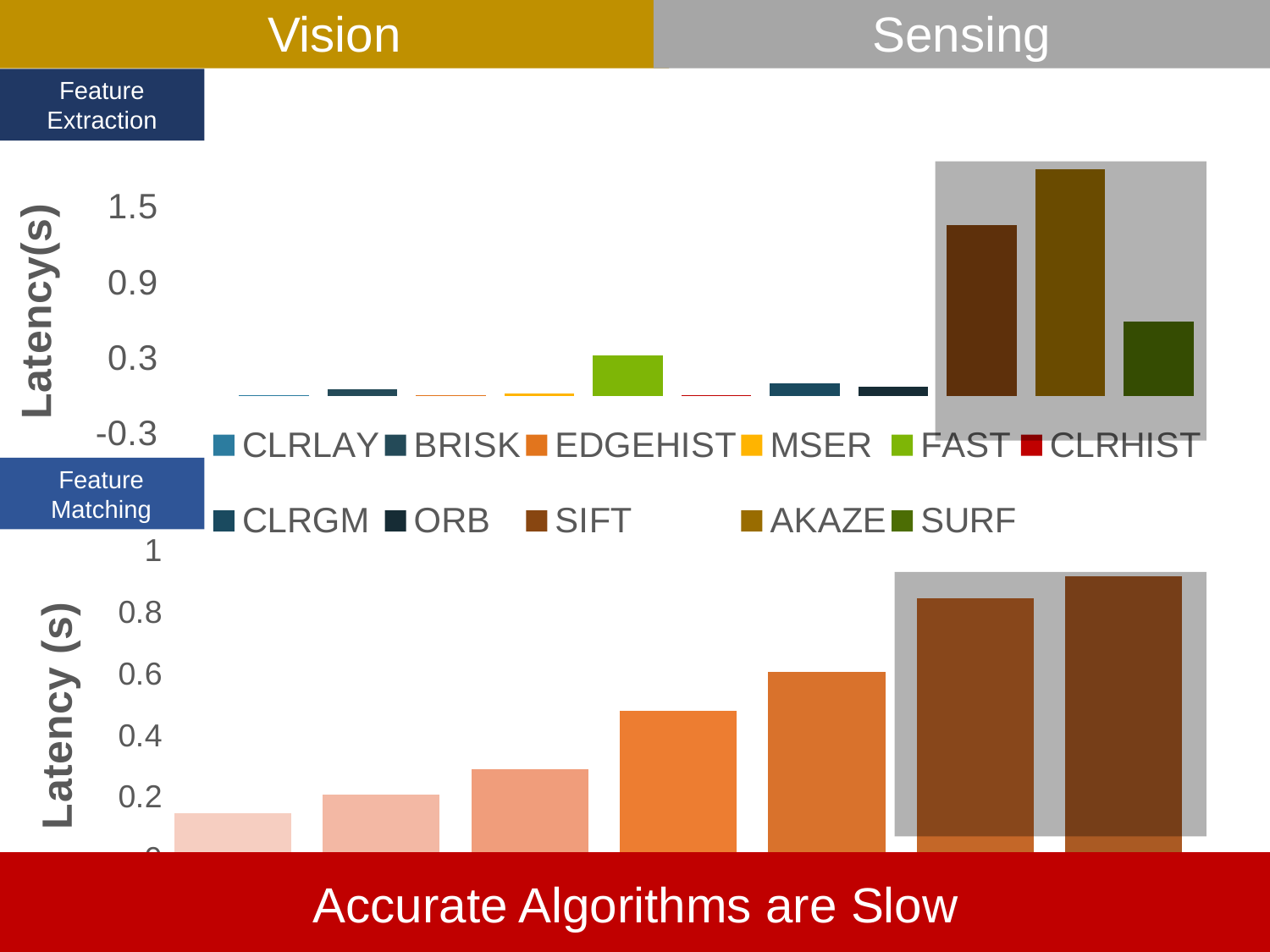
In the Feature Matching chart (bottom), is the value of the rightmost bar greater or less than 0.8? greater What kind of chart is the Feature Matching chart (bottom)? bar chart How many bars are plotted in the Feature Matching chart (bottom)? 7 In the Feature Extraction chart (top), is the latency for SURF greater or less than 0.9? less In the Feature Extraction chart (top), is the latency for SIFT greater or less than 0.9? greater In the Feature Extraction chart (top), which has the higher latency, SIFT or SURF? SIFT How many series does the legend of the Feature Extraction chart (top) list? 11 In the Feature Extraction chart (top), which series has the highest latency? AKAZE In the Feature Extraction chart (top), which has the higher latency, FAST or AKAZE? AKAZE In the Feature Matching chart (bottom), do the bar values rise or fall from left to right? rise